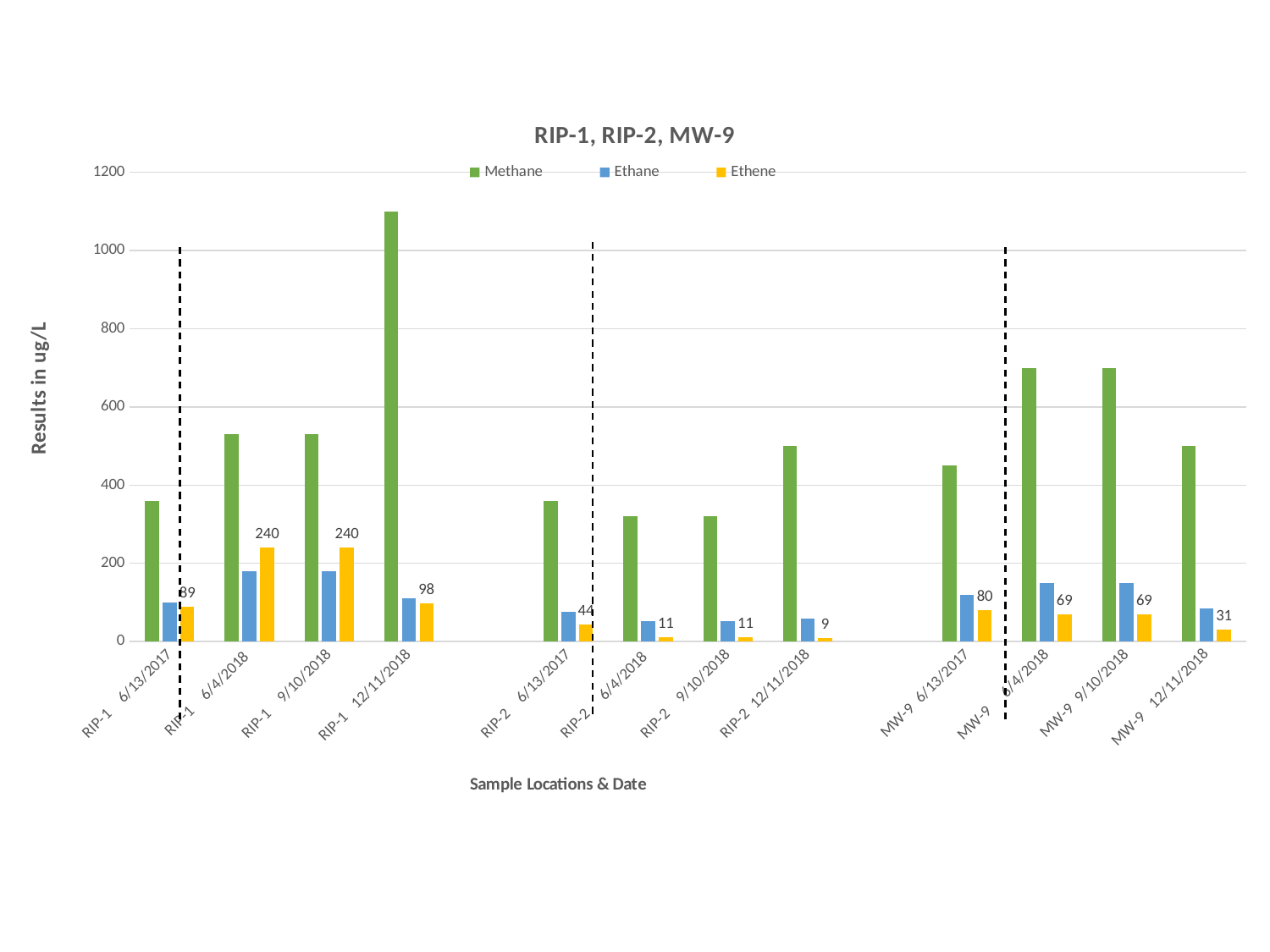
Which sample location and date has the lowest Ethene value? RIP-2 12/11/2018 What is the Ethene value for MW-9 on 12/11/2018? 31 What is the Ethene value for RIP-1 on 6/4/2018? 240 What kind of chart is shown on the slide? bar chart Is the Methane value for RIP-1 on 12/11/2018 greater or less than 1000? greater What is the Ethene value for RIP-2 on 6/13/2017? 44 Which sample location and date has the highest Methane value? RIP-1 12/11/2018 How many sample location and date categories are shown on the x axis? 12 How many series does the legend list? 3 Is the Methane value for MW-9 on 6/4/2018 greater or less than 600? greater What is the difference between the Ethene values for RIP-1 on 6/4/2018 and RIP-1 on 12/11/2018? 142 Which is larger, the Ethene value for RIP-1 on 6/13/2017 or for MW-9 on 6/13/2017? RIP-1 6/13/2017